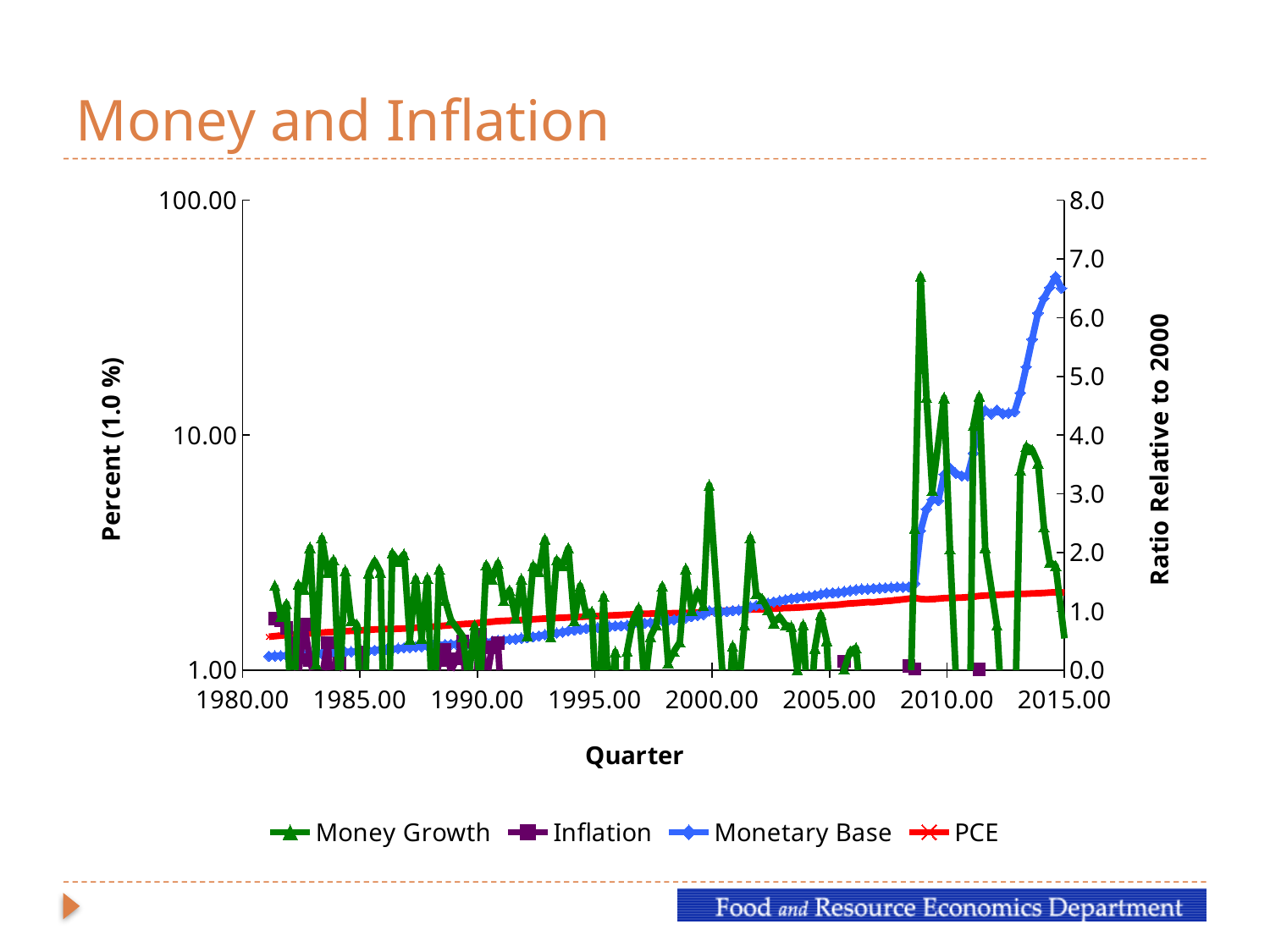
Is the Monetary Base value at the end of the series (around 2015) greater or less than 6.0 on the right axis? greater Is the PCE value around 2015 greater or less than 2.0 on the right axis? less Does the Monetary Base series rise or fall overall from 1980 to 2015? Rise Is the Monetary Base value around 1985 greater or less than 1.0 on the right axis? less Which series reaches the highest point on the left (Percent) axis? Money Growth Does the PCE series rise or fall along the x axis? Rise What is the title of the x axis? Quarter What kind of chart is shown on the slide? Line chart How many series does the legend list? 4 Which series are listed in the legend? Money Growth, Inflation, Monetary Base, PCE Around 2015, which is larger on the right axis: Monetary Base or PCE? Monetary Base